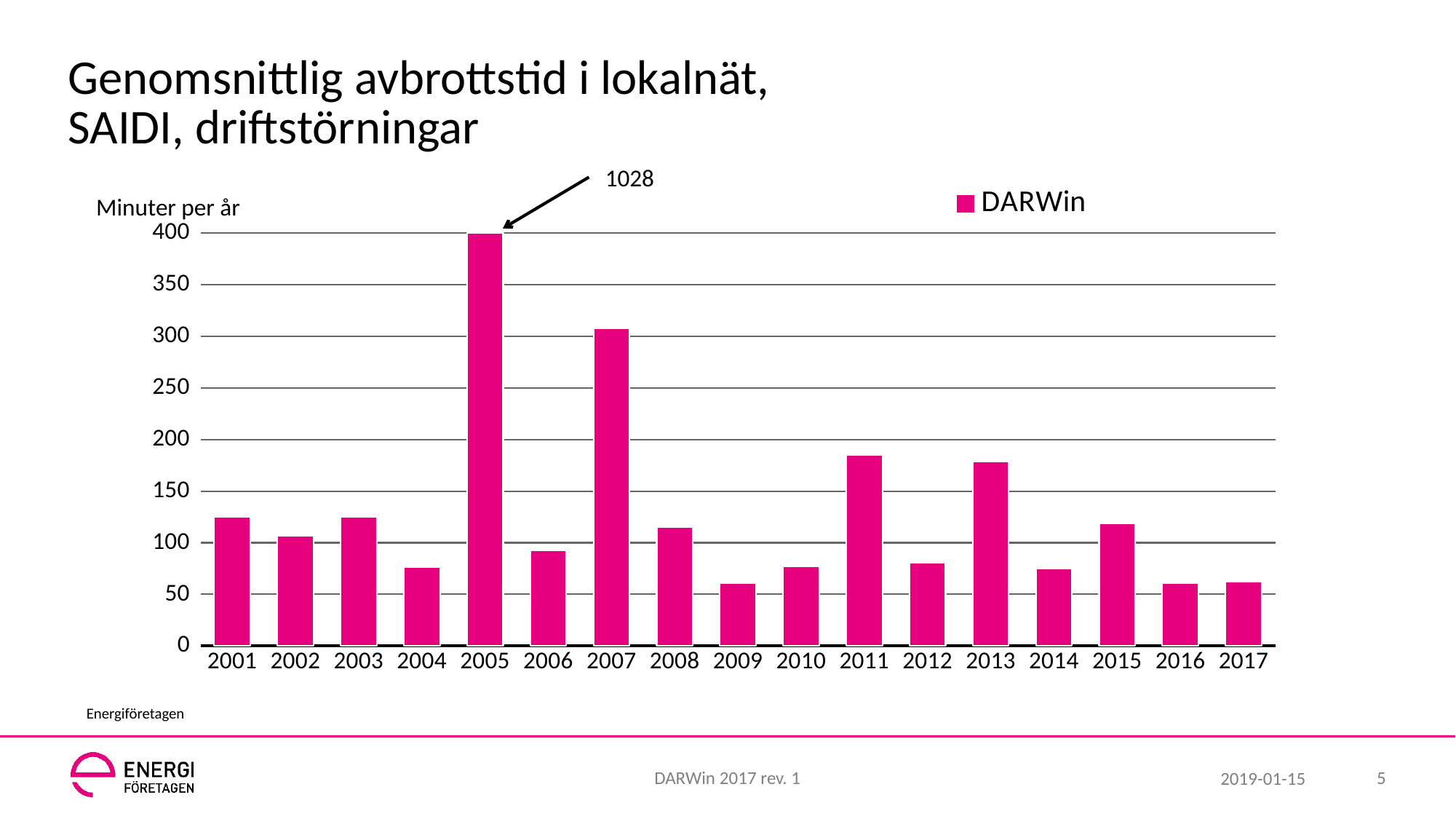
Is the value for 2007 greater or less than 250? greater Is the value for 2009 greater or less than 100? less Is the value for 2011 greater or less than 150? greater What value is annotated for the year 2005? 1028 How many years are shown on the x axis of the chart? 17 What kind of chart is shown on the slide? bar chart Which year has the highest value in the chart? 2005 Which year has the larger value, 2008 or 2012? 2008 What is the name of the series shown in the chart legend? DARWin Which year has the larger value, 2007 or 2011? 2007 How many series does the chart legend list? 1